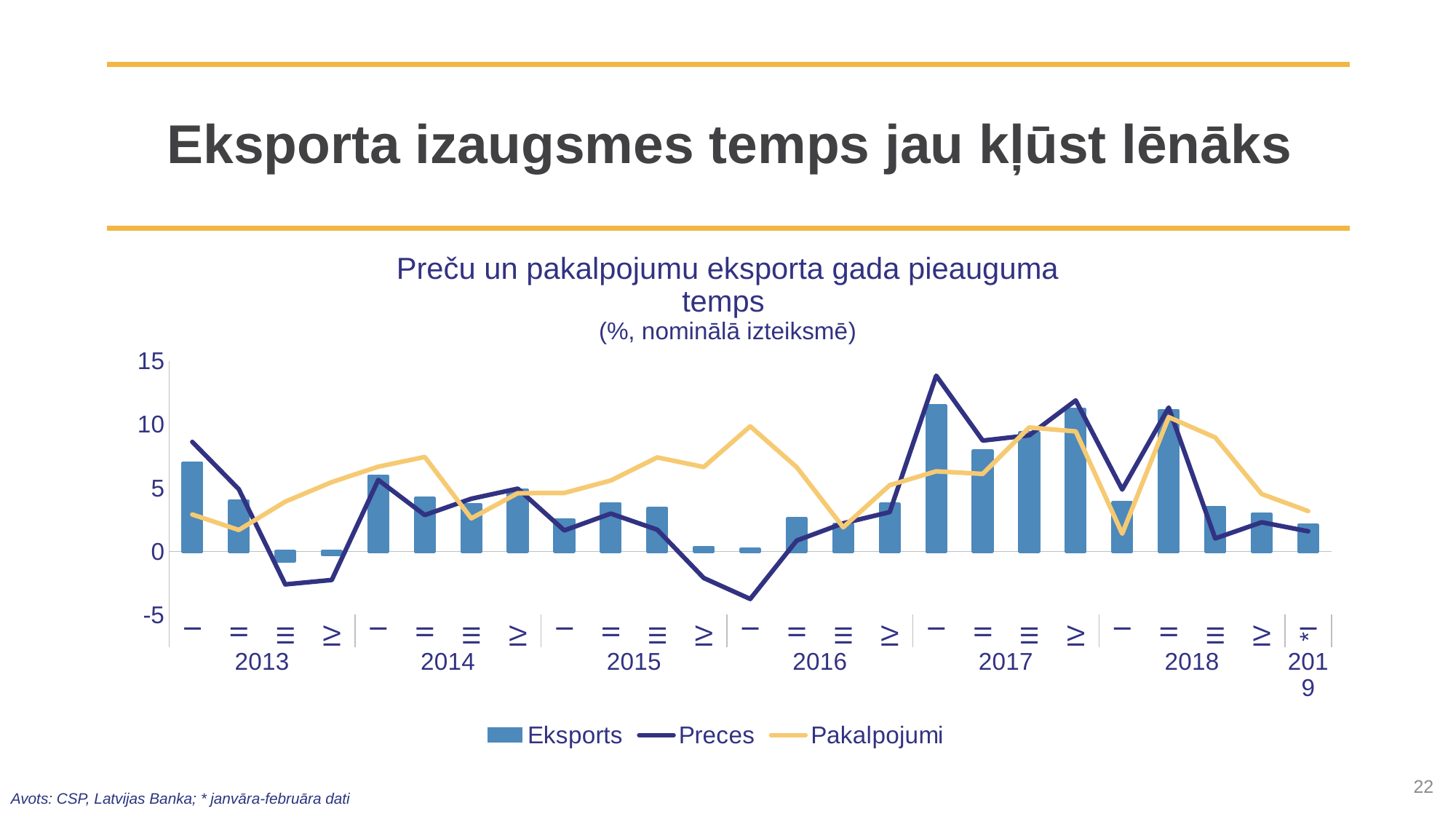
Is the Preces value for 2015 IV greater or less than 0? less Which is larger, the Eksports value for 2013 I or for 2013 II? 2013 I How many series does the legend list? 3 What is the chart's title? Preču un pakalpojumu eksporta gada pieauguma temps (%, nominālā izteiksmē) Do the Eksports bars rise or fall from 2018 II to 2019 I? fall In which quarter does the Preces line reach its lowest value? 2016 I Which series is shown as bars? Eksports Is the Preces value for 2017 I greater or less than 10? greater What kind of chart is this? Combined bar and line chart In which quarter does the Preces line reach its highest value? 2017 I Is the Eksports value for 2013 I greater or less than 5? greater